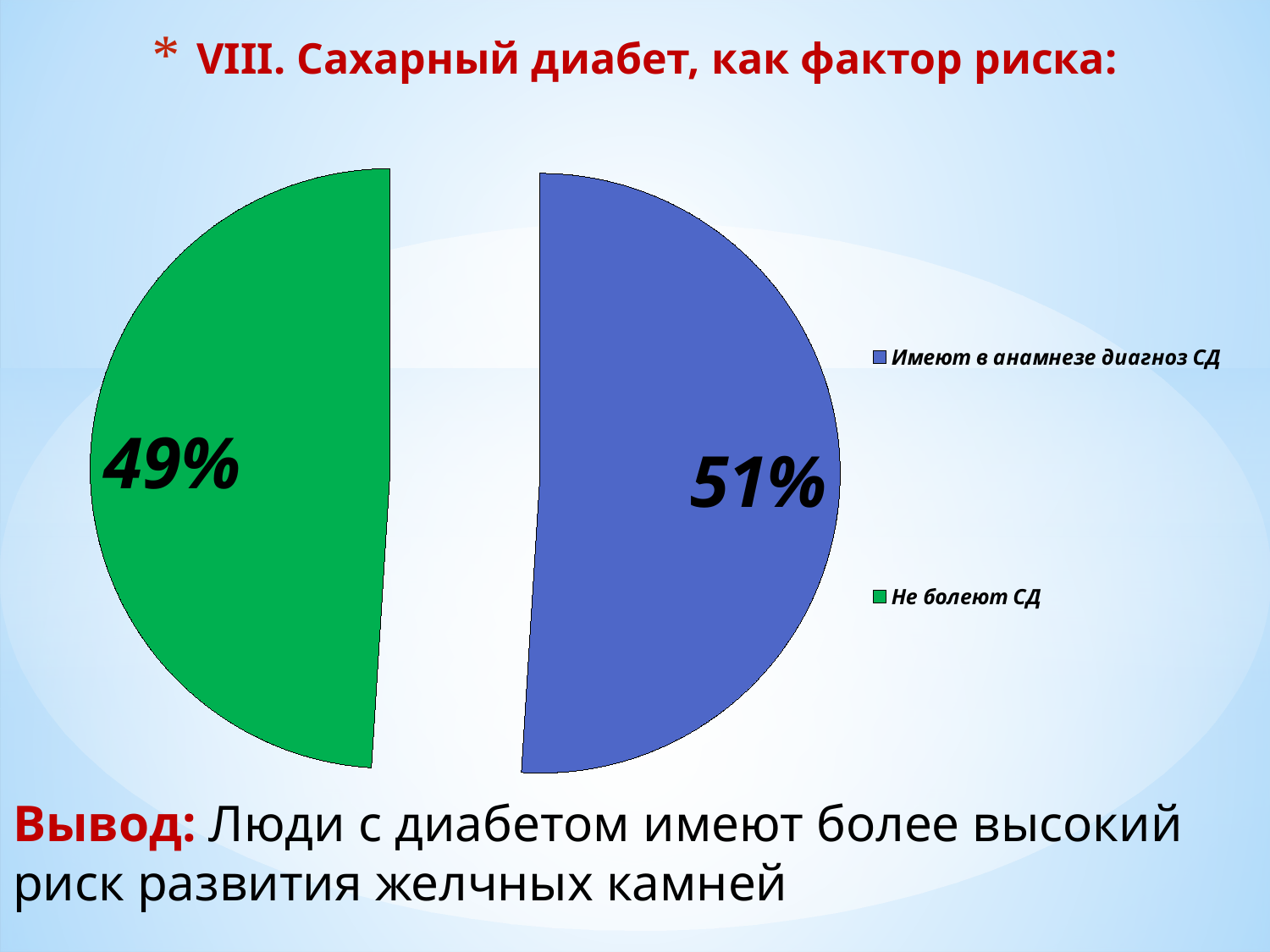
What share of the pie does the green slice represent? 49% How many slices does the pie chart have? 2 What is the difference in percentage points between the "Имеют в анамнезе диагноз СД" slice and the "Не болеют СД" slice? 2% Which category has the smaller share of the pie chart? Не болеют СД What colour is the slice for "Имеют в анамнезе диагноз СД"? blue What percentage of the pie chart is labelled "Не болеют СД"? 49% What kind of chart is shown on the slide? pie chart What percentage of the pie chart is labelled "Имеют в анамнезе диагноз СД"? 51% Is the share for "Не болеют СД" larger or smaller than the share for "Имеют в анамнезе диагноз СД"? smaller Which category has the larger share of the pie chart? Имеют в анамнезе диагноз СД Is the value for "Имеют в анамнезе диагноз СД" greater or less than 50%? greater How many entries does the legend list? 2